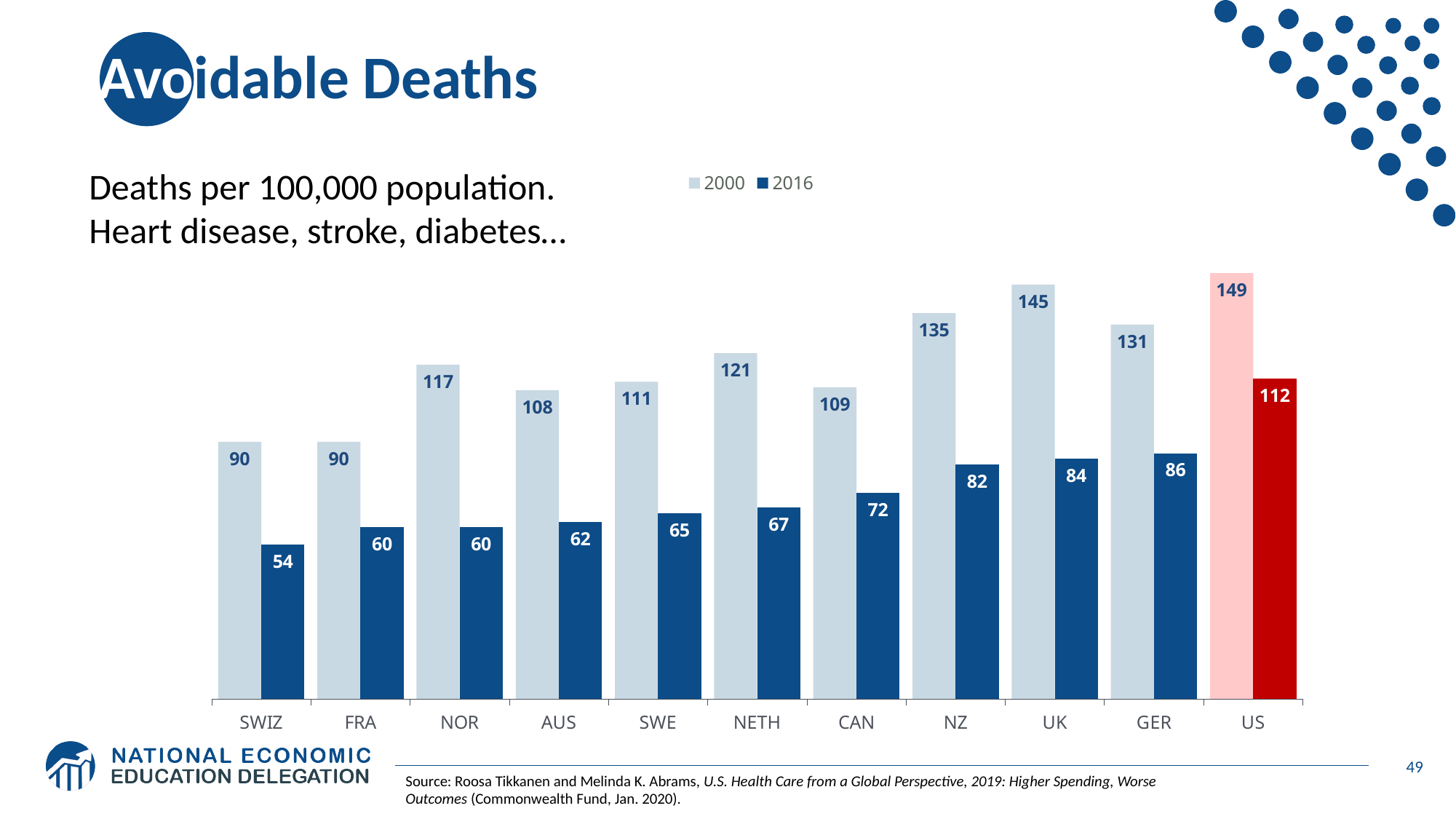
How many countries are shown on the x axis? 11 How many series does the legend list? 2 Which country had the highest value in 2016? US Which is larger, the 2016 value for UK or the 2016 value for CAN? UK Which country's bars are coloured red and pink instead of blue? US What was the value for GER in 2000? 131 What kind of chart is shown on the slide? Bar chart Did the value for every country fall or rise from 2000 to 2016? Fall What is the difference between the US values for 2000 and 2016? 37 What was the value for the US in 2000? 149 Which country had the lowest value in 2016? SWIZ What was the value for SWIZ in 2016? 54